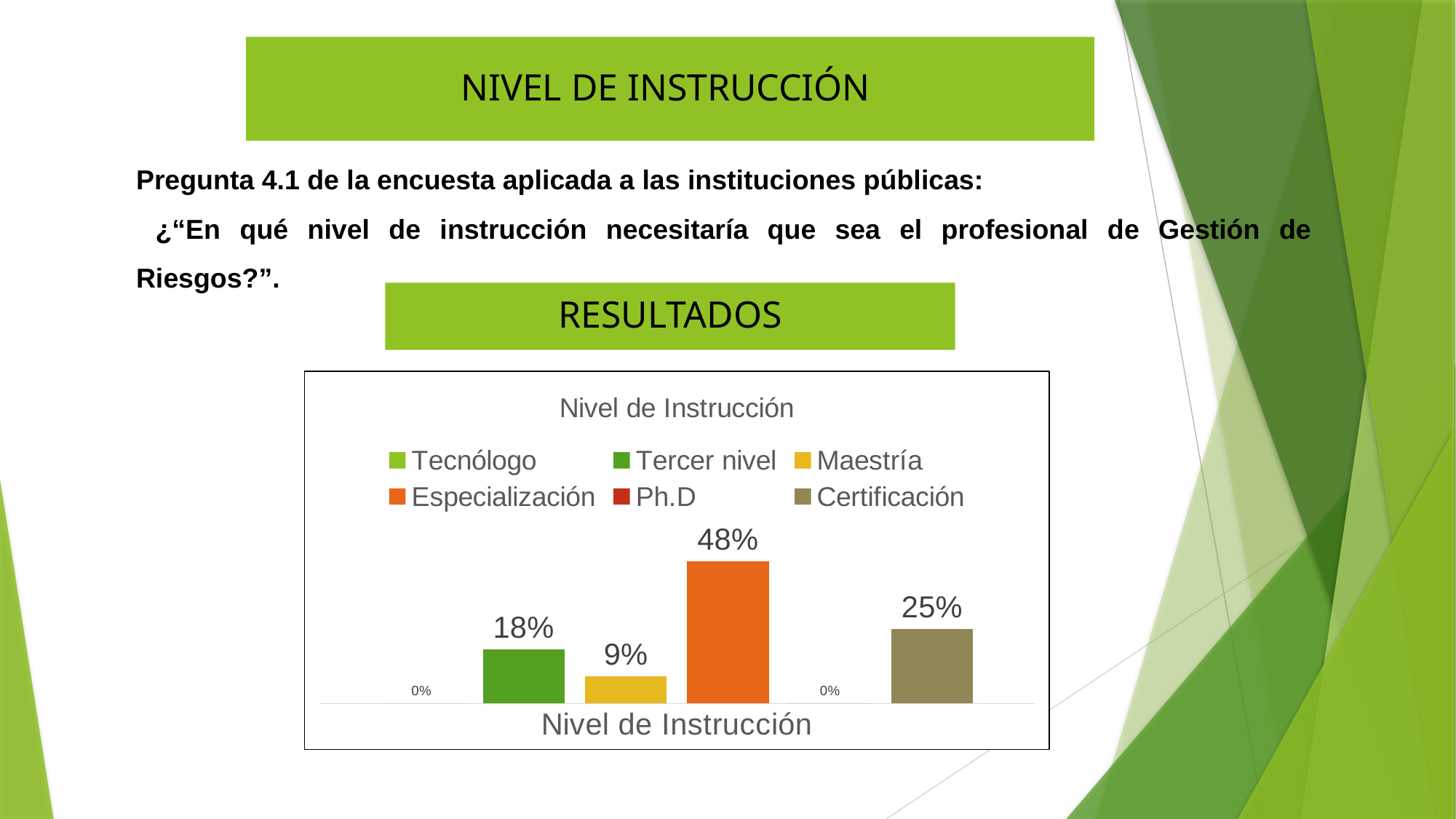
Which is larger, the value for Tercer nivel or the value for Maestría? Tercer nivel What colour is the bar for Especialización? orange How many entries does the chart legend list? 6 What is the value for Ph.D? 0% What is the title of the chart? Nivel de Instrucción What is the value for Tercer nivel? 18% What type of chart is shown on the slide? bar chart What is the value for Maestría? 9% Which category has the highest value? Especialización What is the value for Especialización? 48% What is the difference between the values for Especialización and Certificación? 23% What is the value for Certificación? 25%